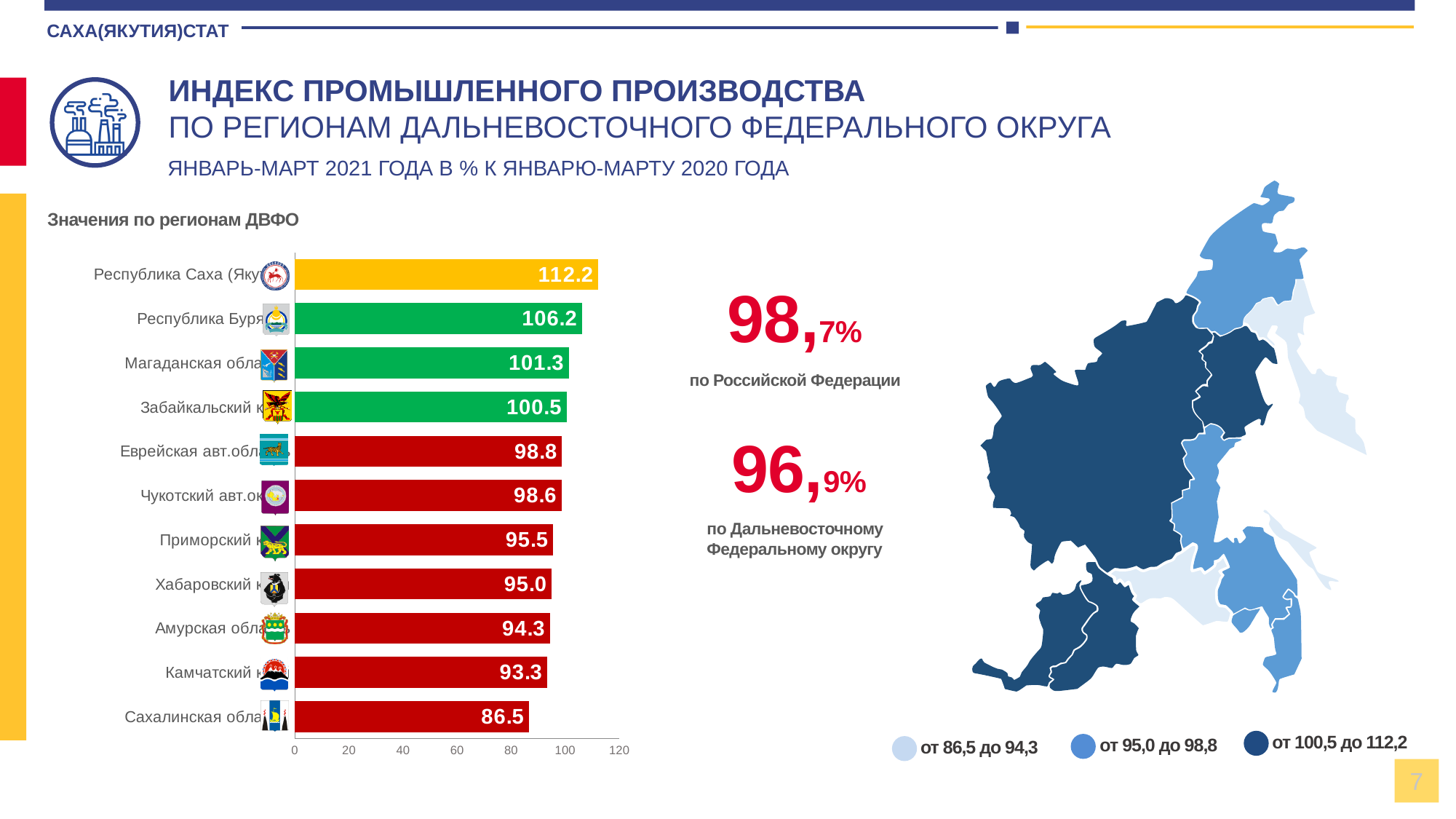
Which region has the highest value in the bar chart? Республика Саха (Якутия) Which has a larger value, Приморский край or Хабаровский край? Приморский край What is the difference between the values for Республика Бурятия and Забайкальский край? 5.7 What value is shown for Магаданская область in the bar chart? 101.3 How many regions are shown in the bar chart? 11 Which region has the lowest value in the bar chart? Сахалинская область What type of chart is used to show the values by region? bar chart What colour are the bars for regions with values below 100? red What is the industrial production index value shown for Республика Саха (Якутия)? 112.2 What is the difference between the values for Республика Саха (Якутия) and Сахалинская область? 25.7 What value is shown for Камчатский край in the bar chart? 93.3 Is the value for Амурская область greater or less than 100? less